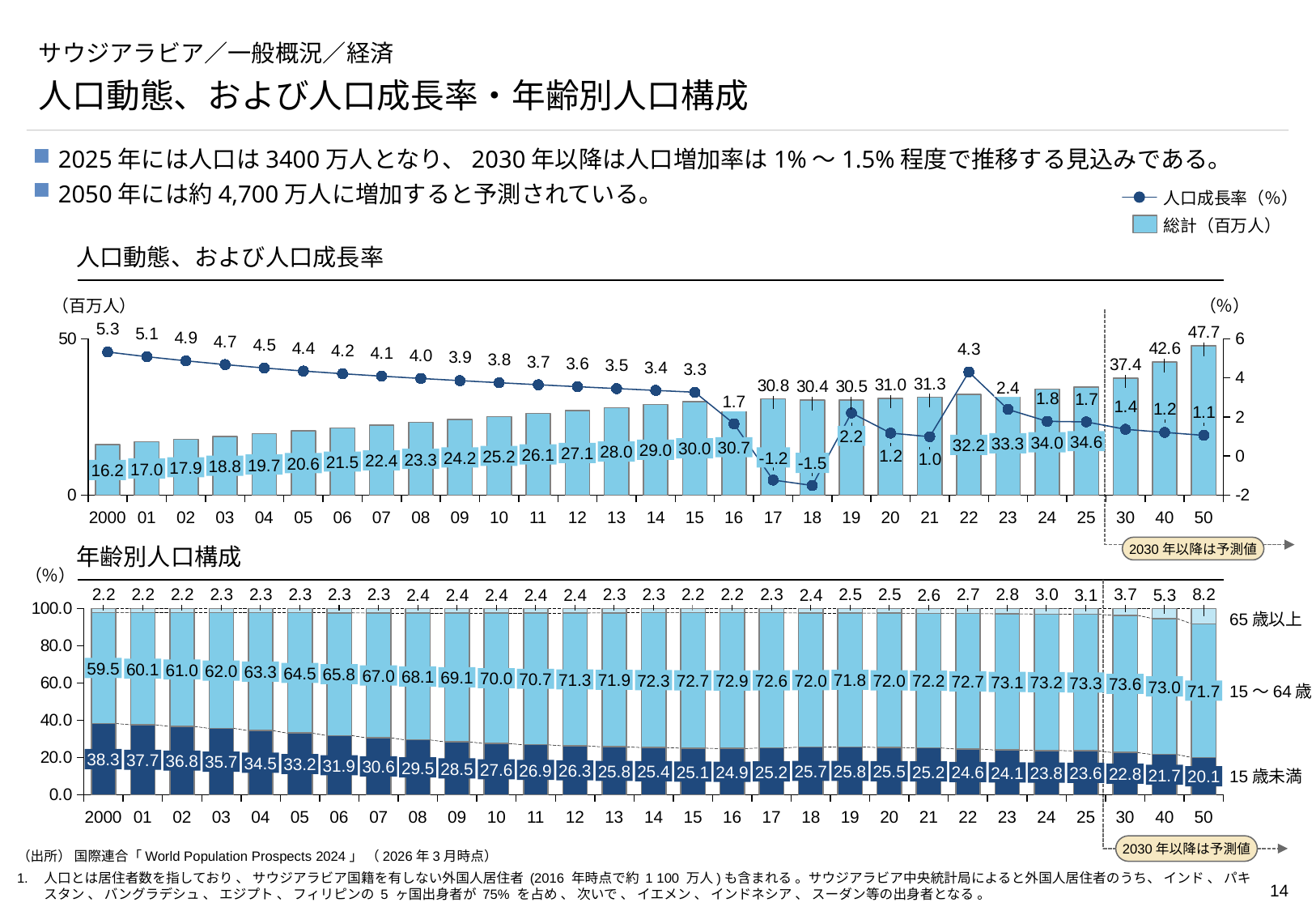
In the bottom chart (年齢別人口構成), what is the 65歳以上 value for 2050? 8.2 In the bottom chart (年齢別人口構成), what is the 15歳未満 value for 2000? 38.3 In the top chart (人口動態、および人口成長率), what is the 人口成長率 (%) value for 2018? -1.5 In the top chart (人口動態、および人口成長率), which year has the higher 人口成長率, 2019 or 2022? 2022 How many years are plotted on the x axis of the top chart (人口動態、および人口成長率)? 29 In the top chart (人口動態、および人口成長率), which year has the lowest 人口成長率? 2018 How many series does the legend of the top chart (人口動態、および人口成長率) list? 2 What kind of chart is the bottom chart (年齢別人口構成)? Stacked bar chart In the top chart (人口動態、および人口成長率), what is the difference between the 総計 values for 2050 and 2000? 31.5 In the top chart (人口動態、および人口成長率), which year has the highest 総計 value? 2050 In the bottom chart (年齢別人口構成), does the 15歳未満 share rise or fall from 2000 to 2050? Fall In the top chart (人口動態、および人口成長率), what is the 総計 (百万人) value for 2025? 34.6